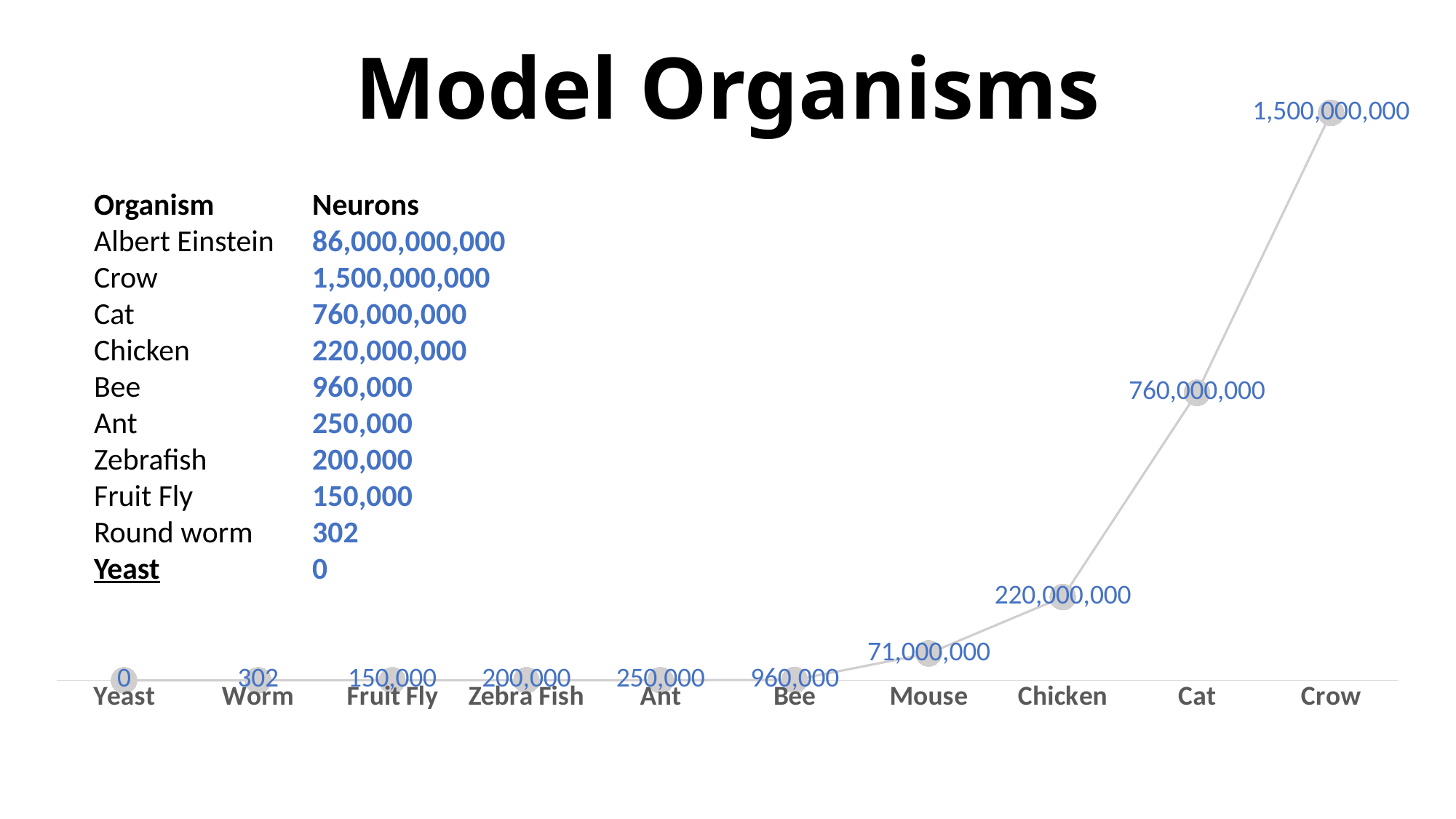
How many categories are plotted on the chart? 10 What is the value plotted for Worm? 302 What is the value plotted for Bee? 960,000 Which is larger, the value for Cat or the value for Chicken? Cat Which category has the highest value on the chart? Crow Do the values rise or fall moving from left to right along the x axis? Rise Which category has the lowest value on the chart? Yeast What is the difference between the values for Ant and Zebra Fish? 50,000 What kind of chart is shown on the slide? Line chart What is the difference between the values for Crow and Cat? 740,000,000 What is the value plotted for Chicken? 220,000,000 What is the value plotted for Mouse? 71,000,000